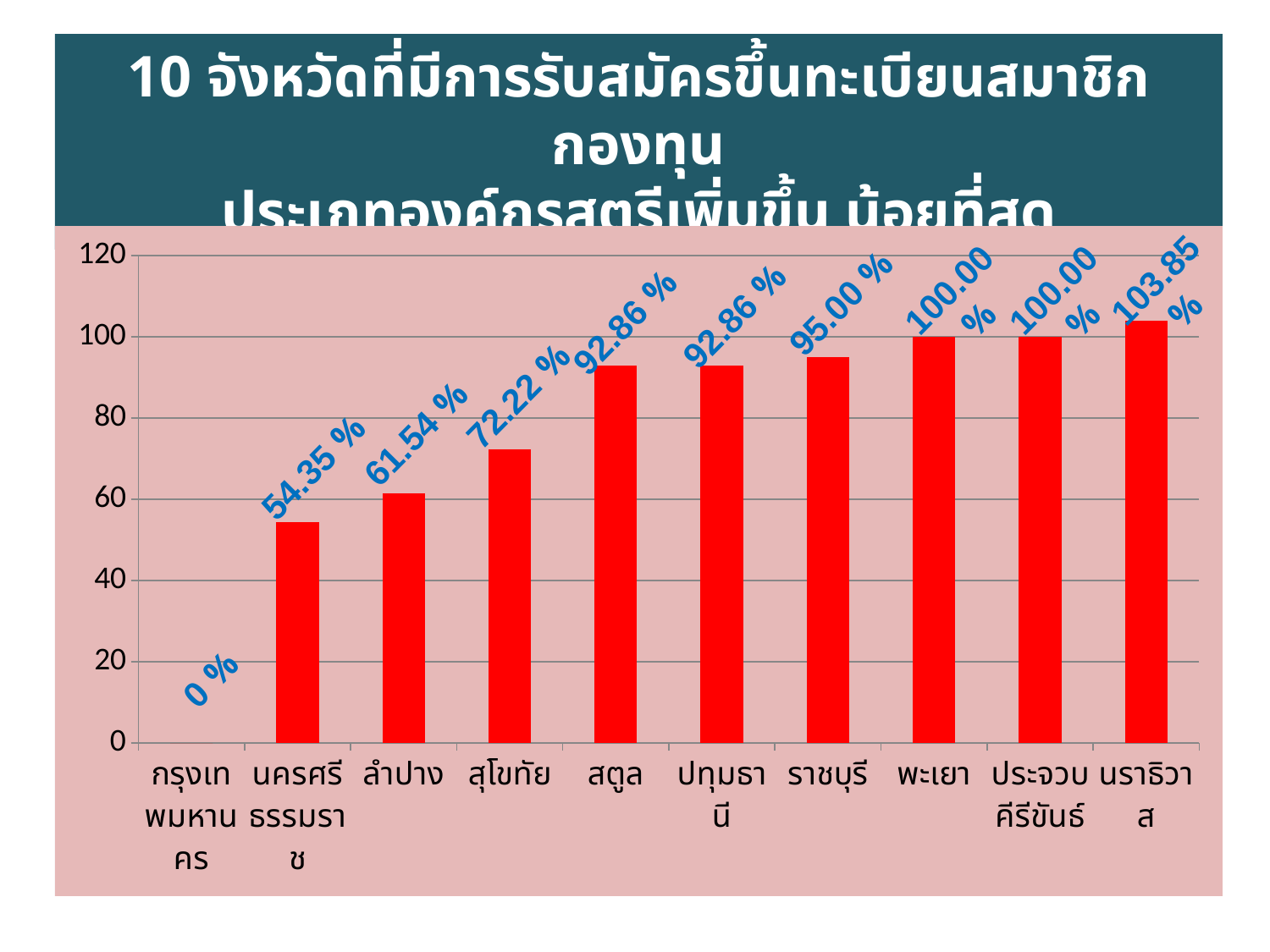
What is the difference between the values for นราธิวาส and พะเยา? 3.85 % Which province has the lowest value? กรุงเทพมหานคร What is the value for สุโขทัย? 72.22 % Is the value for ปทุมธานี greater or less than 80? greater What is the value for กรุงเทพมหานคร? 0 % Which province has the highest value? นราธิวาส What is the value for ราชบุรี? 95.00 % What kind of chart is shown on the slide? bar chart What is the value for ลำปาง? 61.54 % What colour are the bars in the chart? red How many provinces are shown on the chart? 10 Which is larger, the value for นครศรีธรรมราช or the value for สตูล? สตูล